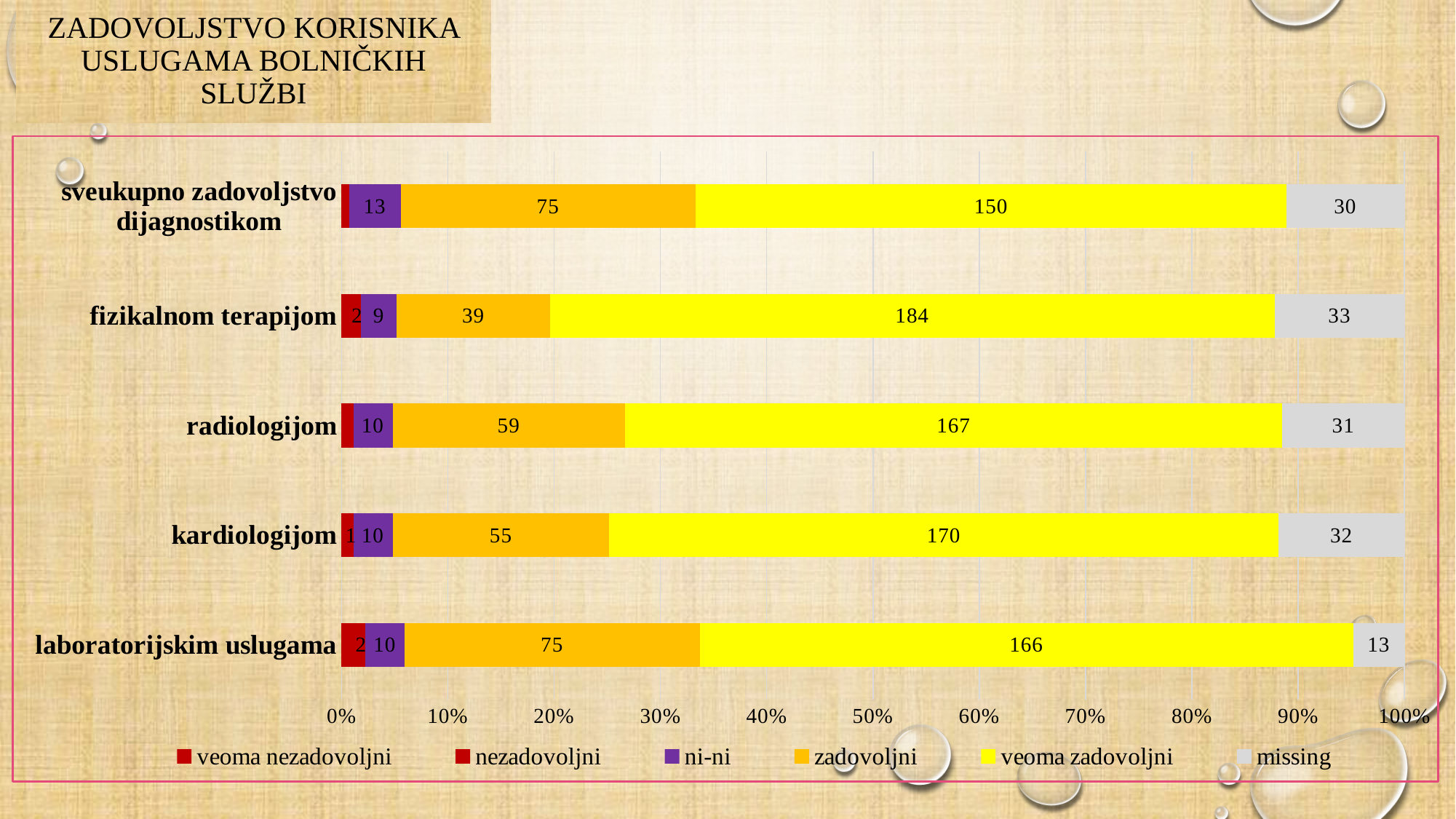
Which category has the highest "veoma zadovoljni" value? fizikalnom terapijom Which category has the lowest "zadovoljni" value? fizikalnom terapijom What is the difference between the "veoma zadovoljni" values for "kardiologijom" and "radiologijom"? 3 What is the "missing" value for "laboratorijskim uslugama"? 13 What is the value of the "veoma zadovoljni" segment for "fizikalnom terapijom"? 184 How many series does the legend list? 6 How many categories are shown on the chart? 5 Which category has the lowest "missing" value? laboratorijskim uslugama What is the "ni-ni" value for "sveukupno zadovoljstvo dijagnostikom"? 13 What is the difference between the "missing" values for "fizikalnom terapijom" and "laboratorijskim uslugama"? 20 Which has a larger "zadovoljni" value: "sveukupno zadovoljstvo dijagnostikom" or "fizikalnom terapijom"? sveukupno zadovoljstvo dijagnostikom What is the value of the "zadovoljni" segment for "radiologijom"? 59